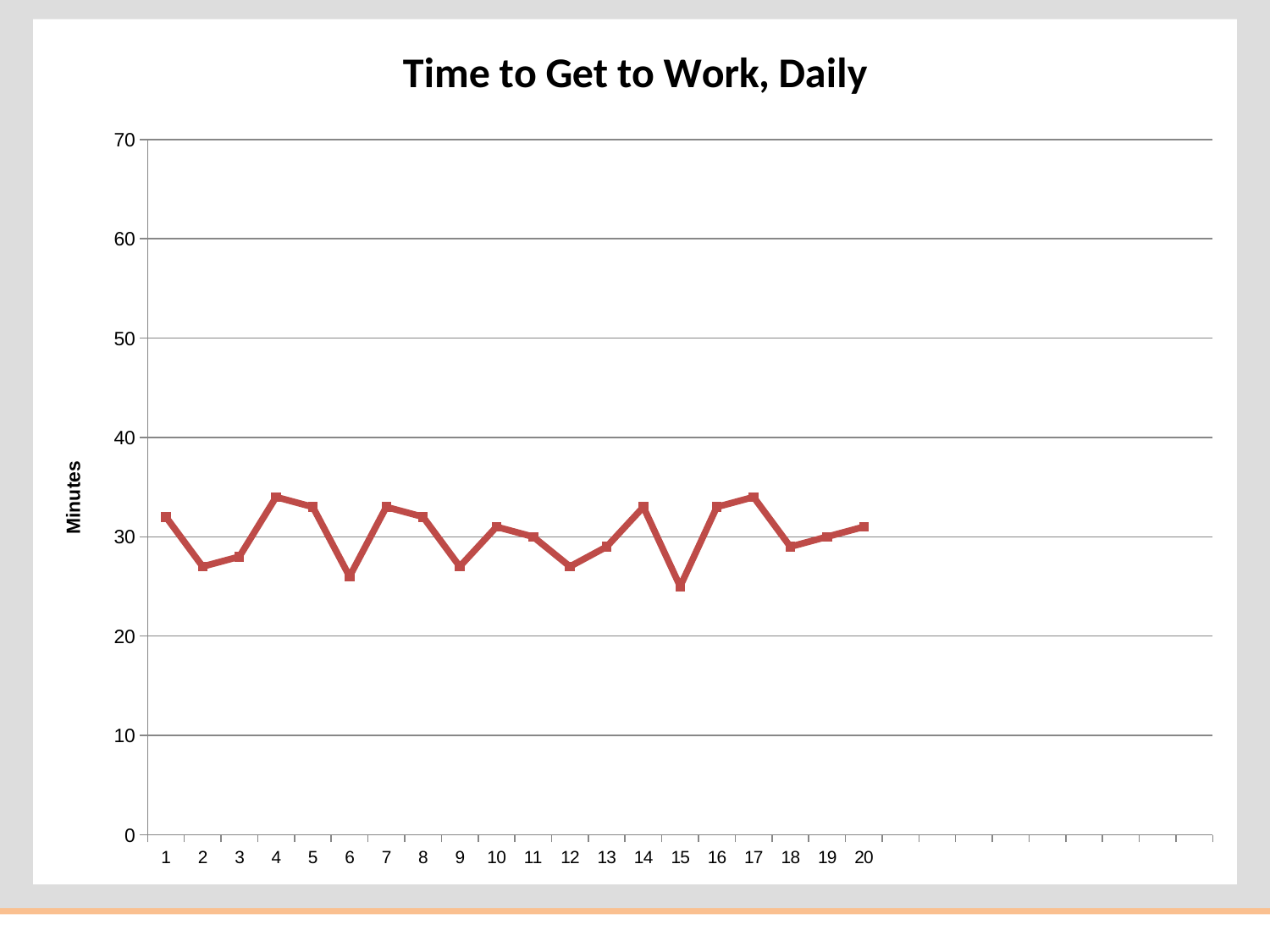
Which has the larger value, day 2 or day 14? day 14 What is the label on the vertical axis? Minutes Which has the larger value, day 4 or day 6? day 4 Is the value for day 4 greater or less than 30? greater Is the value for day 2 greater or less than 30? less Is the value for day 6 greater or less than 30? less What kind of chart is shown on the slide? line chart How many days are plotted on the chart? 20 Which has the larger value, day 15 or day 1? day 1 What is the title of the chart? Time to Get to Work, Daily